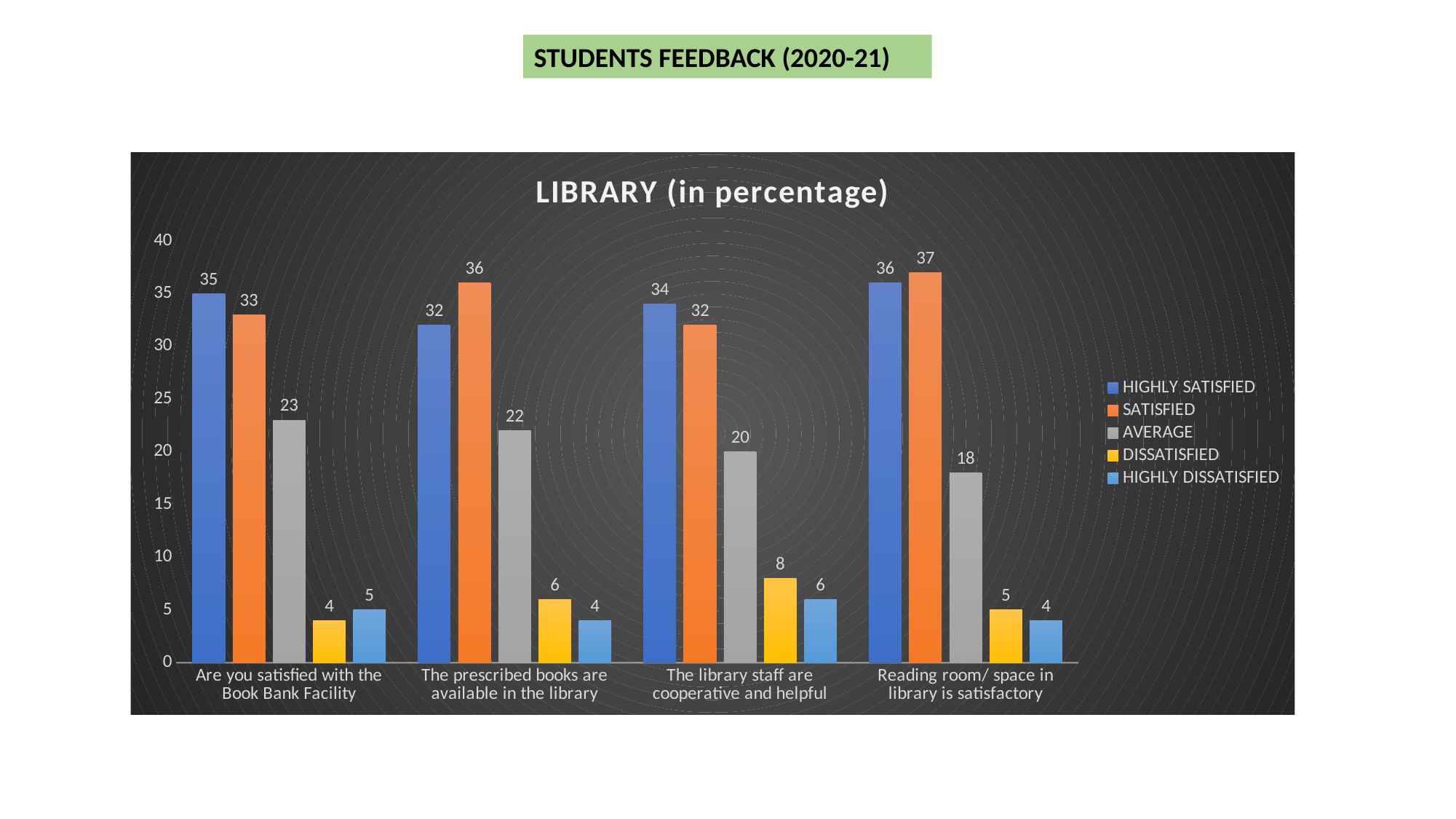
What kind of chart is shown on the slide? Bar chart What is the difference between the HIGHLY SATISFIED and SATISFIED values for "The prescribed books are available in the library"? 4 Which is larger for "The library staff are cooperative and helpful": DISSATISFIED or HIGHLY DISSATISFIED? DISSATISFIED What is the HIGHLY SATISFIED value for "Are you satisfied with the Book Bank Facility"? 35 What is the DISSATISFIED value for "The prescribed books are available in the library"? 6 What is the SATISFIED value for "Reading room/ space in library is satisfactory"? 37 What is the title of the chart? LIBRARY (in percentage) Which category has the lowest AVERAGE value? Reading room/ space in library is satisfactory How many categories are shown on the x axis? 4 Which category has the highest SATISFIED value? Reading room/ space in library is satisfactory How many series does the legend list? 5 What is the AVERAGE value for "The library staff are cooperative and helpful"? 20